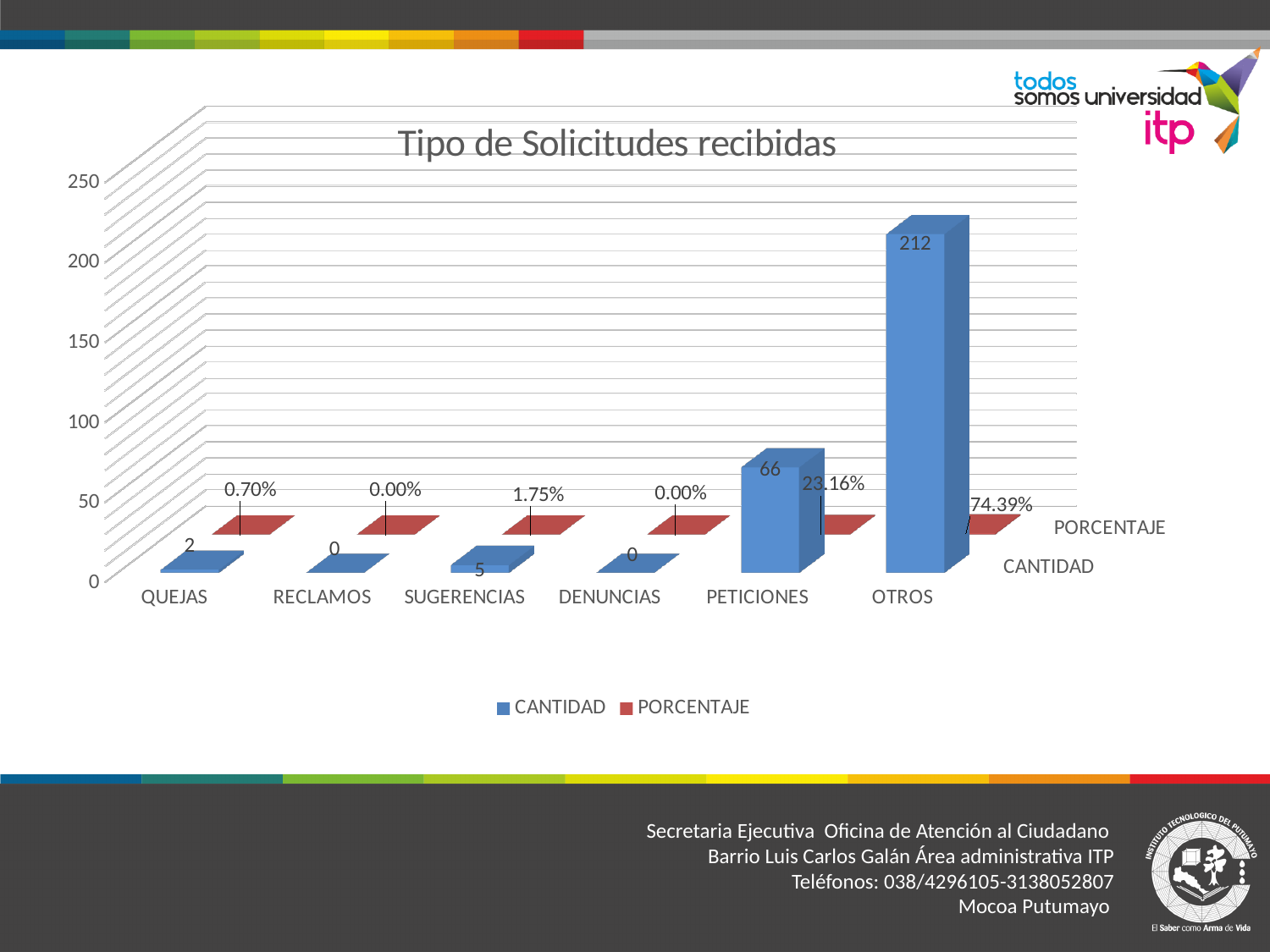
Which category has the highest CANTIDAD value? OTROS What is the title of the chart? Tipo de Solicitudes recibidas What is the CANTIDAD value for PETICIONES? 66 How many series does the legend list? 2 What kind of chart is shown on the slide? bar chart What is the PORCENTAJE value for QUEJAS? 0.70% What is the CANTIDAD value for OTROS? 212 Is the CANTIDAD value for OTROS greater or less than 200? greater Which has a larger CANTIDAD value, QUEJAS or SUGERENCIAS? SUGERENCIAS What is the PORCENTAJE value for SUGERENCIAS? 1.75% What is the difference between the CANTIDAD values for OTROS and PETICIONES? 146 How many categories are shown on the x axis? 6